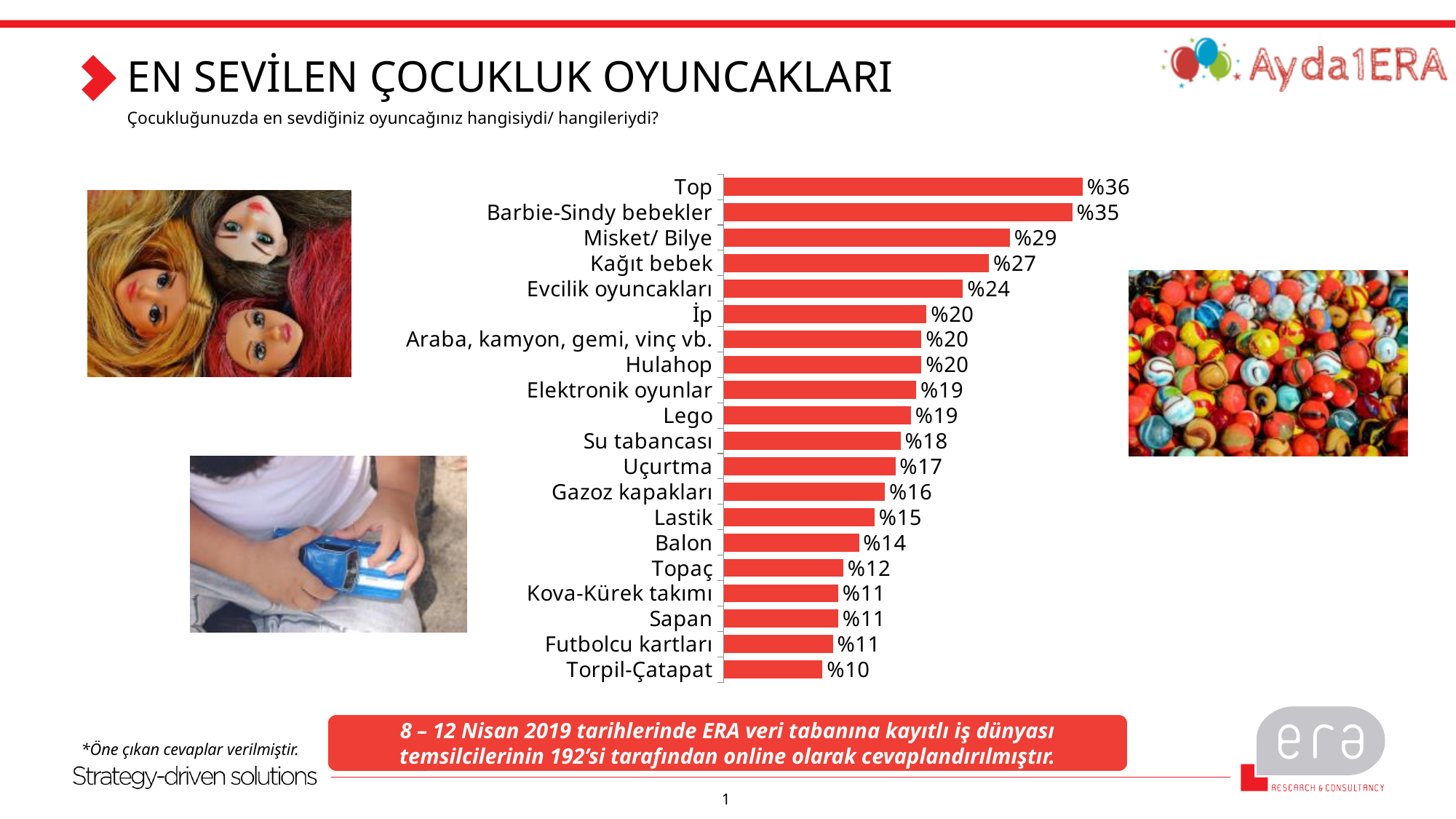
What colour are the bars in the chart? Red Which category has the lowest value? Torpil-Çatapat What is the value for Lego? %19 How many categories are shown in the chart? 20 What is the value for Top? %36 What is the difference between the values for Top and Barbie-Sindy bebekler? %1 What is the value for Torpil-Çatapat? %10 What is the value for Misket/ Bilye? %29 Which is larger, the value for Evcilik oyuncakları or the value for Su tabancası? Evcilik oyuncakları Which category has the highest value? Top What is the difference between the values for Kağıt bebek and Balon? %13 What kind of chart is shown on the slide? Bar chart